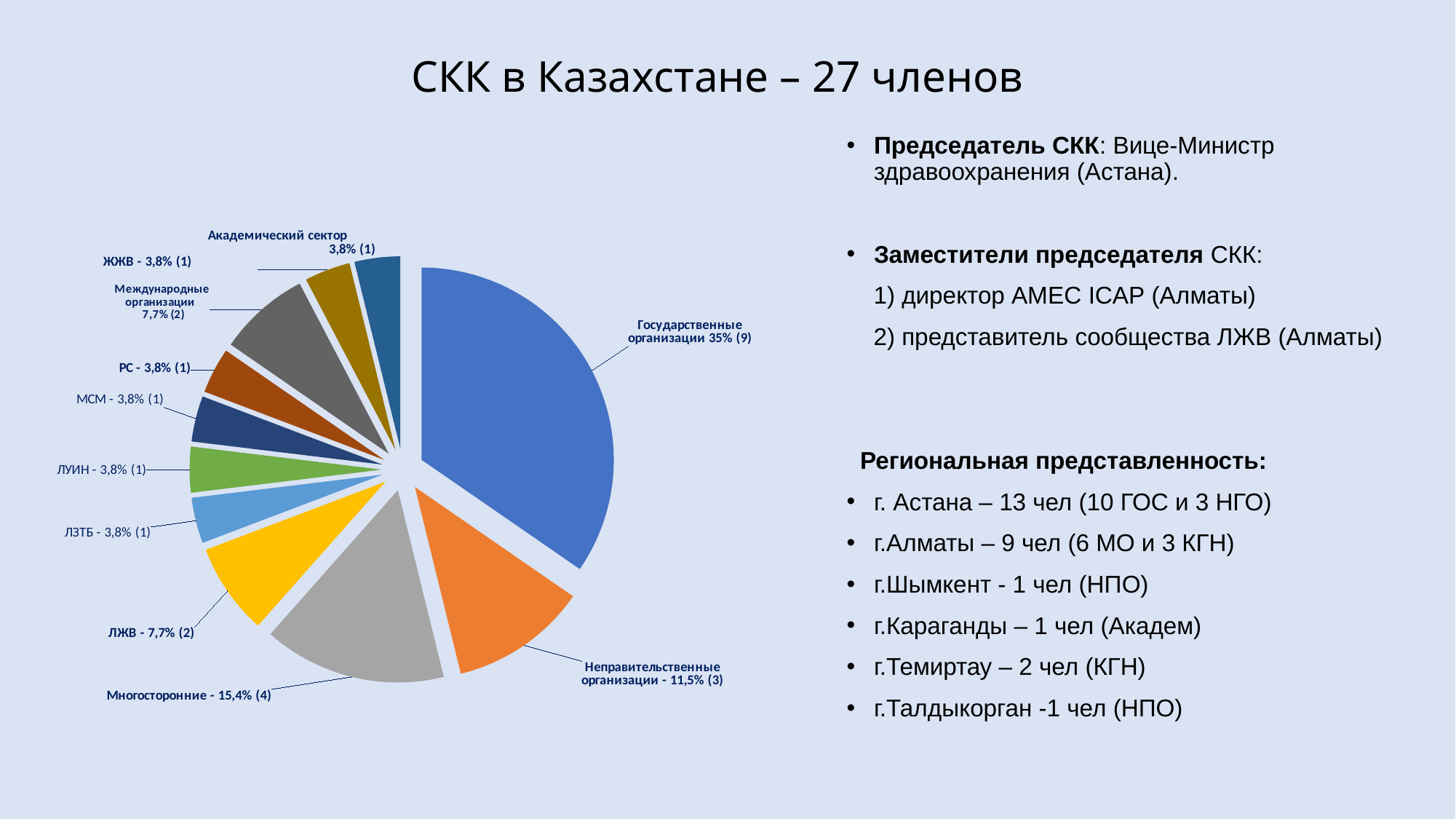
How many slices are labelled 3,8% (1)? 6 What percentage is shown for Многосторонние? 15,4% What is the value shown for Неправительственные организации? 11,5% (3) Which is larger, the slice for Многосторонние or the slice for Неправительственные организации? Многосторонние What percentage is shown for ЛЖВ? 7,7% How many members are in the Международные организации slice? 2 What kind of chart is shown on the slide? pie chart What colour is the slice for Неправительственные организации? orange How many slices does the pie chart have? 11 What is the difference in percentage points between Государственные организации and Неправительственные организации? 23,5 Which category has the largest slice of the pie? Государственные организации What share of the pie do Государственные организации hold? 35%